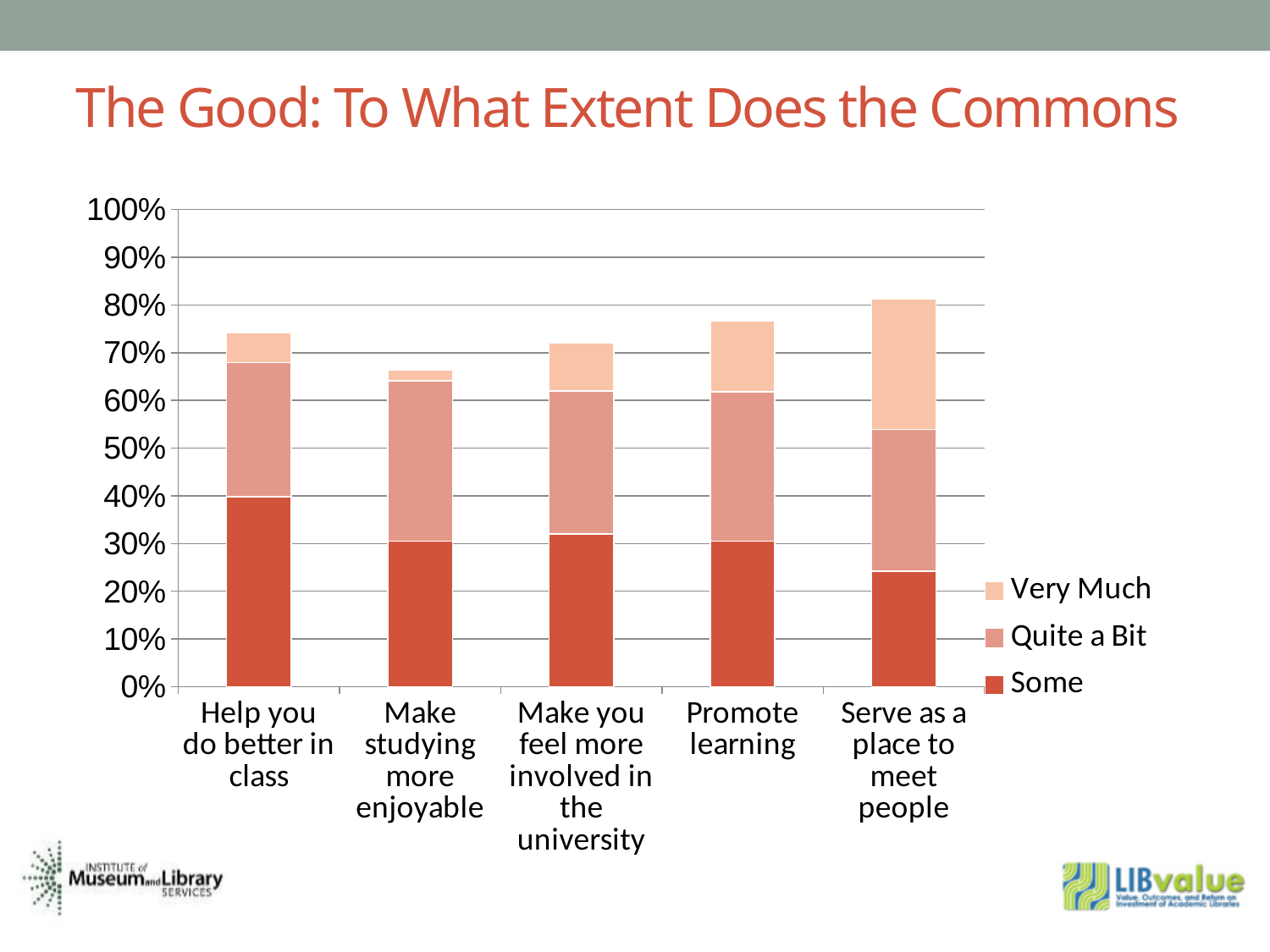
Which category has the smallest 'Some' segment? Serve as a place to meet people Which category has the tallest stacked bar overall? Serve as a place to meet people Is the 'Some' value for 'Help you do better in class' greater or less than 30%? greater What kind of chart is shown on the slide? Stacked bar chart Which category has the shortest stacked bar overall? Make studying more enjoyable What are the three entries listed in the chart's legend? Very Much, Quite a Bit, Some How many series does the chart's legend list? 3 Is the total stacked value for 'Serve as a place to meet people' greater or less than 70%? greater Which category has the largest 'Very Much' segment? Serve as a place to meet people How many categories are shown along the x axis of the chart? 5 Is the total stacked value for 'Make studying more enjoyable' greater or less than 70%? less Which has the larger 'Some' segment: 'Help you do better in class' or 'Serve as a place to meet people'? Help you do better in class